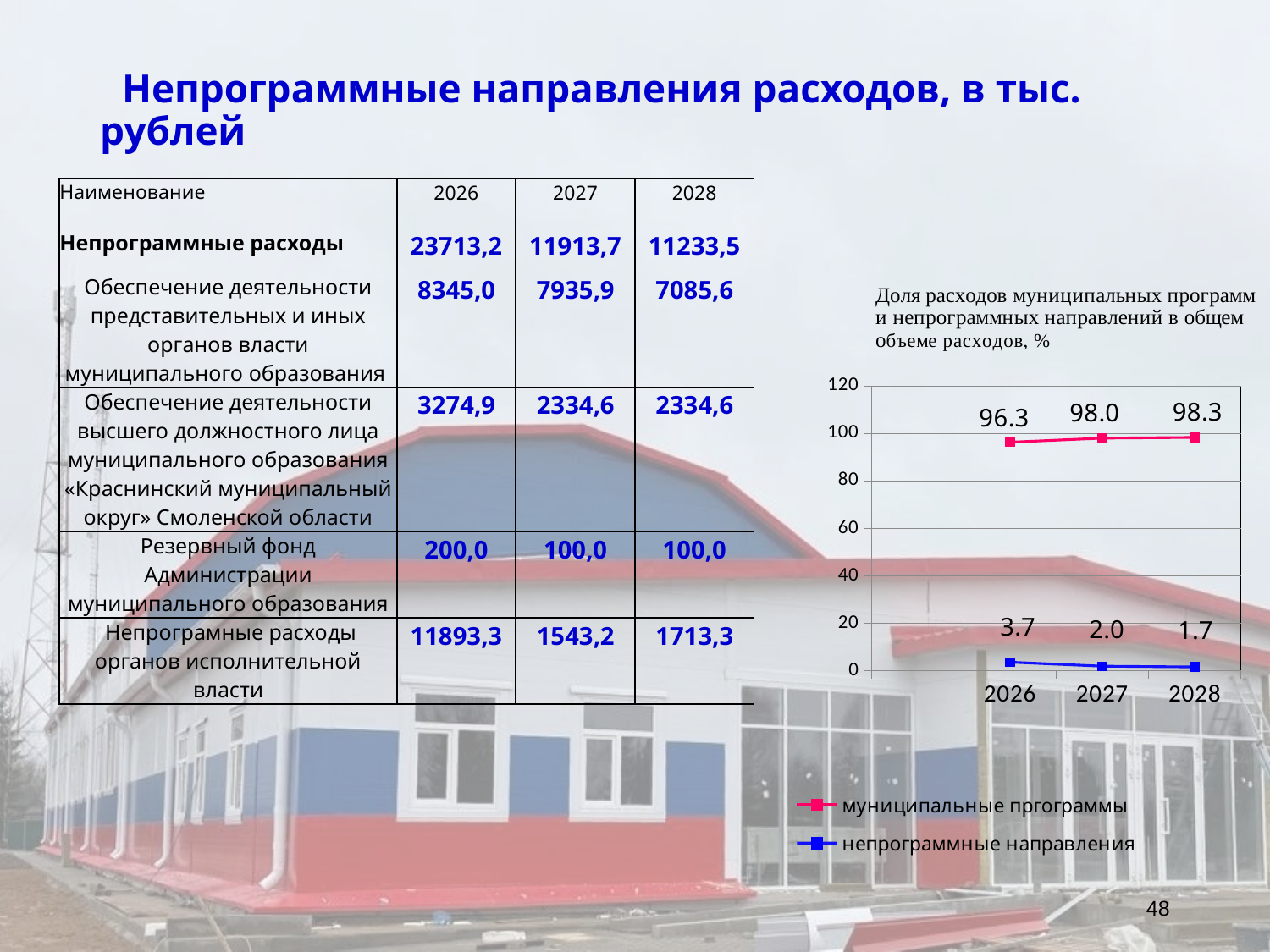
What is the value for муниципальные программы in 2026? 96.3 Which is larger in 2027: муниципальные программы or непрограммные направления? муниципальные программы Does the value for непрограммные направления rise or fall from 2026 to 2028? fall How many years are plotted on the x axis of the chart? 3 What is the value for непрограммные направления in 2028? 1.7 What type of chart is shown on the slide? line chart In which year is the value for непрограммные направления lowest? 2028 What is the value for непрограммные направления in 2026? 3.7 What is the value for муниципальные программы in 2027? 98.0 What is the difference between the муниципальные программы values for 2028 and 2026? 2.0 How many series does the chart legend list? 2 In which year is the value for муниципальные программы highest? 2028